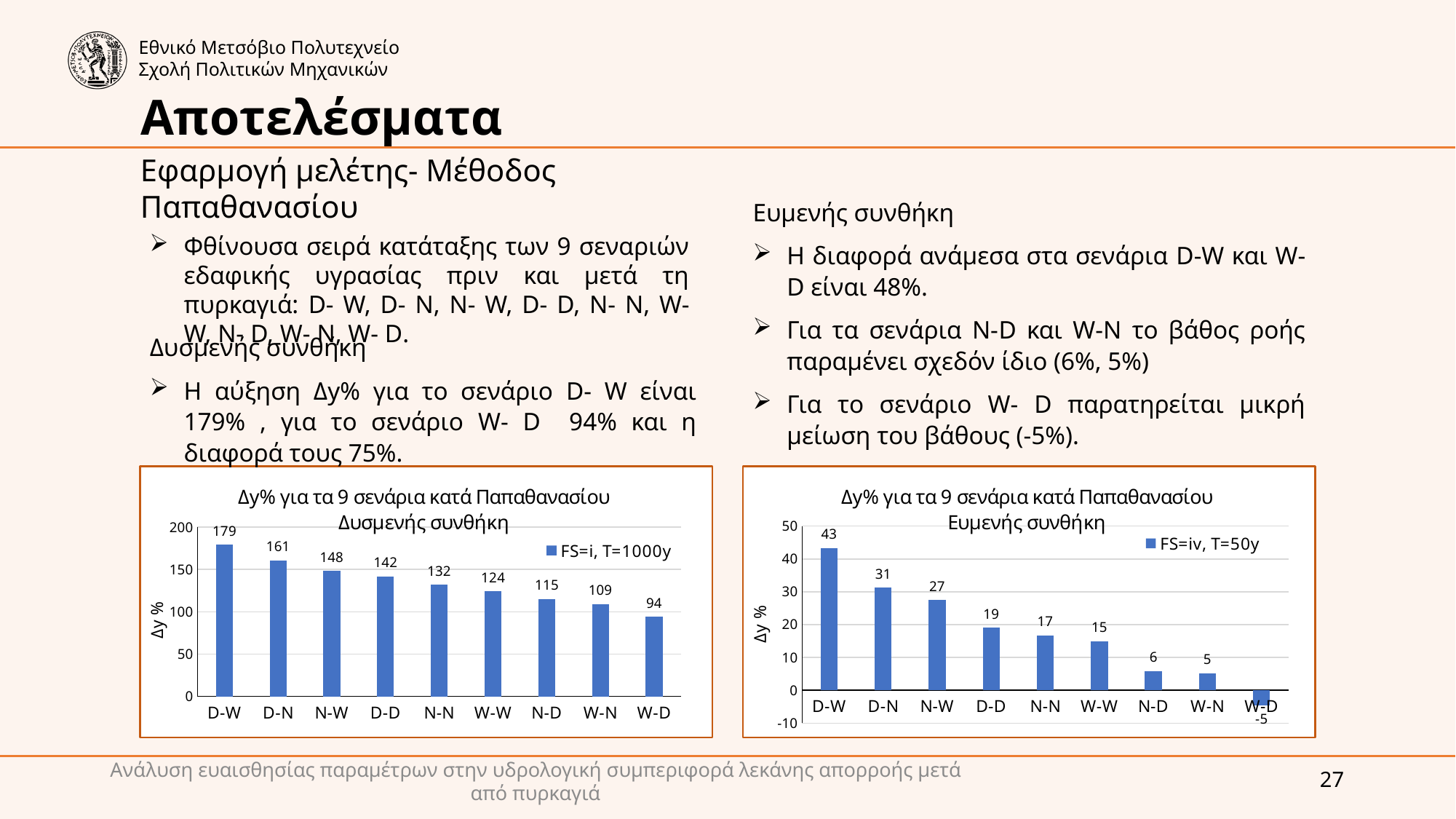
In the left chart (Δυσμενής συνθήκη), is the value for D-D greater or less than 150? less In the left chart (Δυσμενής συνθήκη), what is the Δy% value for the D-W scenario? 179 In the left chart (Δυσμενής συνθήκη), what is the difference between the D-W and W-D values? 85 In the right chart (Ευμενής συνθήκη), which scenario has the highest Δy% value? D-W In the right chart (Ευμενής συνθήκη), what is the Δy% value for the W-D scenario? -5 How many series does the legend of the left chart (Δυσμενής συνθήκη) list? 1 What is the legend entry of the right chart (Ευμενής συνθήκη)? FS=iv, T=50y In the left chart (Δυσμενής συνθήκη), which scenario has the lowest Δy% value? W-D How many scenarios are shown on the x axis of the right chart (Ευμενής συνθήκη)? 9 In the right chart (Ευμενής συνθήκη), what is the difference between the D-W and D-N values? 12 What type of chart is the right chart (Ευμενής συνθήκη)? Bar chart In the left chart (Δυσμενής συνθήκη), which is larger, the value for N-N or the value for W-W? N-N